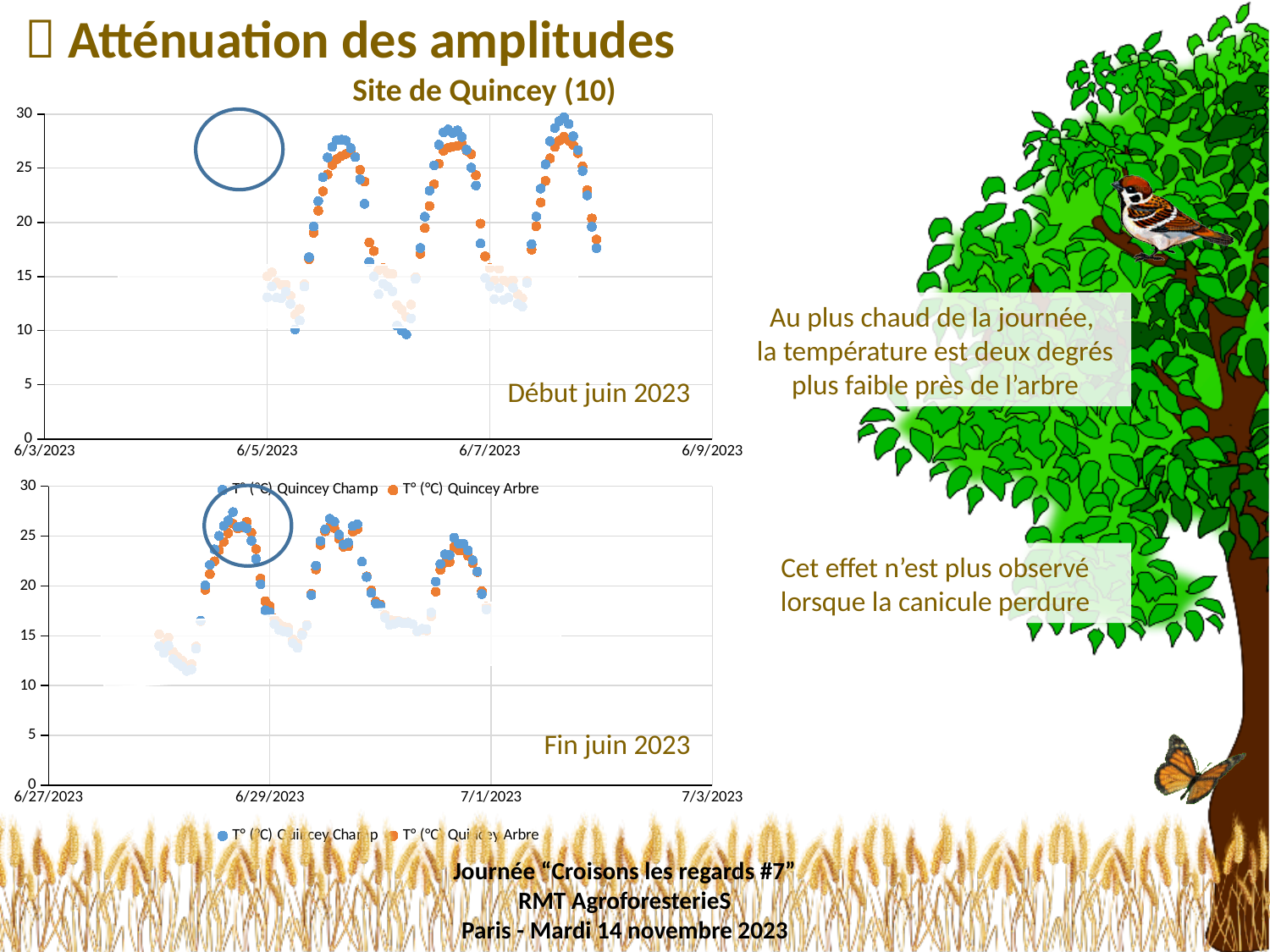
In the bottom chart (Fin juin 2023), is the highest value for T° (°C) Quincey Champ greater or less than 25? greater What is the first date label on the x axis of the bottom chart (Fin juin 2023)? 6/27/2023 In the bottom chart (Fin juin 2023), is the lowest value for T° (°C) Quincey Arbre greater or less than 15? less In the top chart (Début juin 2023), at the daily temperature peaks, which series reaches higher values: T° (°C) Quincey Champ or T° (°C) Quincey Arbre? T° (°C) Quincey Champ What kind of chart is the top chart (Début juin 2023)? Scatter chart How many series does the legend of the bottom chart (Fin juin 2023) list? 2 What is the title shown above the top chart? Site de Quincey (10) What is the maximum value shown on the y axis of the top chart (Début juin 2023)? 30 How many date labels are shown on the x axis of the bottom chart (Fin juin 2023)? 4 In the top chart (Début juin 2023), is the highest value for T° (°C) Quincey Champ greater or less than 25? greater In the top chart (Début juin 2023), which series is plotted in orange? T° (°C) Quincey Arbre